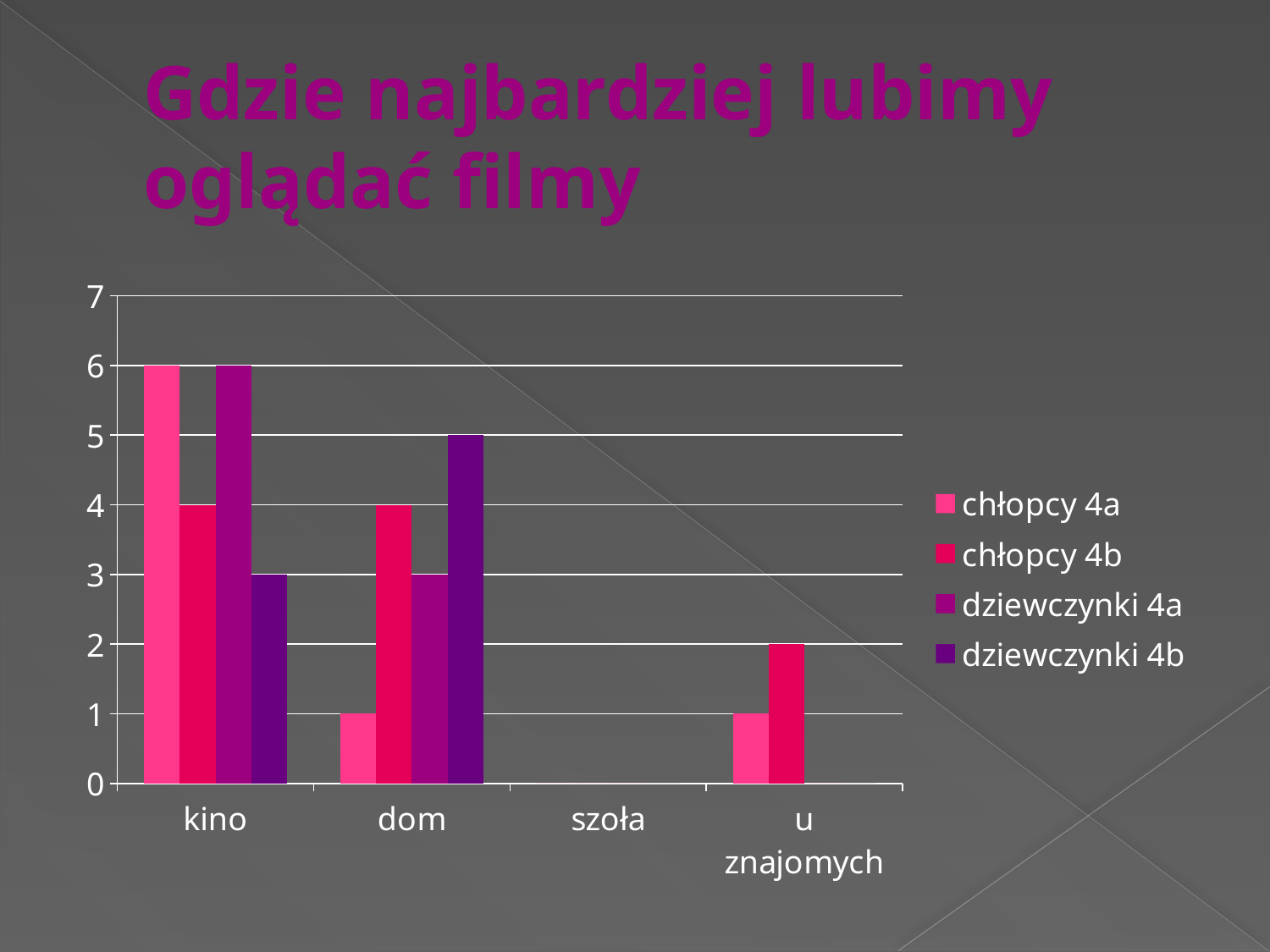
How many categories are shown on the x axis? 4 What is the difference between the chłopcy 4a values for kino and dom? 5 What kind of chart is shown on the slide? bar chart In which category does dziewczynki 4b have its lowest non-zero value? kino What is the value for chłopcy 4b in the u znajomych category? 2 What is the value for dziewczynki 4a in the dom category? 3 What is the value for chłopcy 4a in the kino category? 6 What is the value for dziewczynki 4b in the dom category? 5 What is the title of the chart on the slide? Gdzie najbardziej lubimy oglądać filmy Which is larger in the kino category: chłopcy 4b or dziewczynki 4b? chłopcy 4b How many series does the legend list? 4 In which category does chłopcy 4b have its highest value? kino and dom